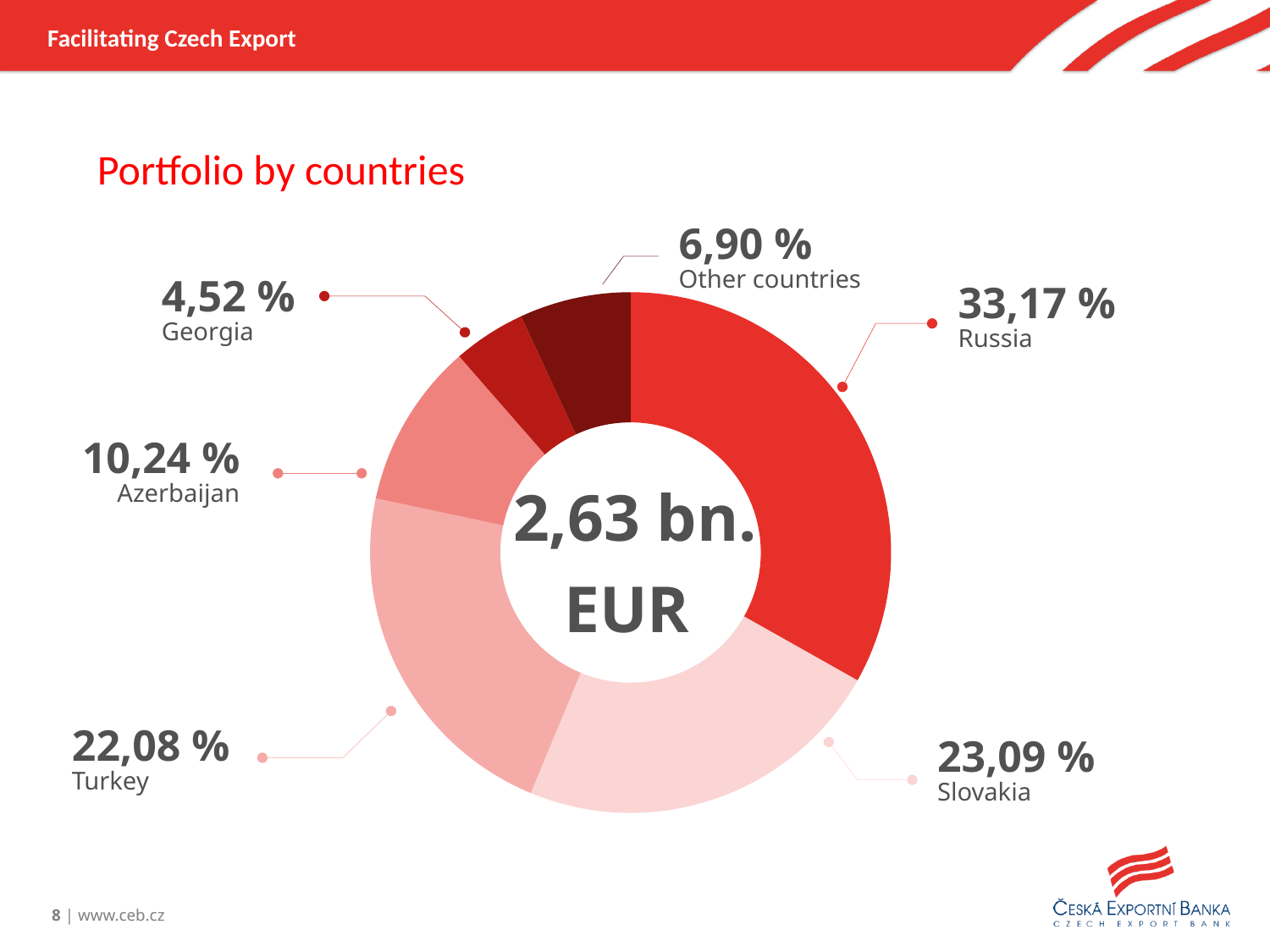
Which named country has the smallest share of the portfolio? Georgia What type of chart is shown on the slide? Pie chart (donut) What share of the portfolio does Azerbaijan account for? 10,24 % Which has a larger share of the portfolio, Slovakia or Turkey? Slovakia Which country has the largest share of the portfolio? Russia What share of the portfolio does Russia account for? 33,17 % What is the difference between the shares of Azerbaijan and Georgia? 5,72 % What share of the portfolio is attributed to Other countries? 6,90 % What total value is shown in the centre of the chart? 2,63 bn. EUR How many slices does the chart have? 6 What is the difference between the shares of Russia and Slovakia? 10,08 % What is the title of the chart? Portfolio by countries